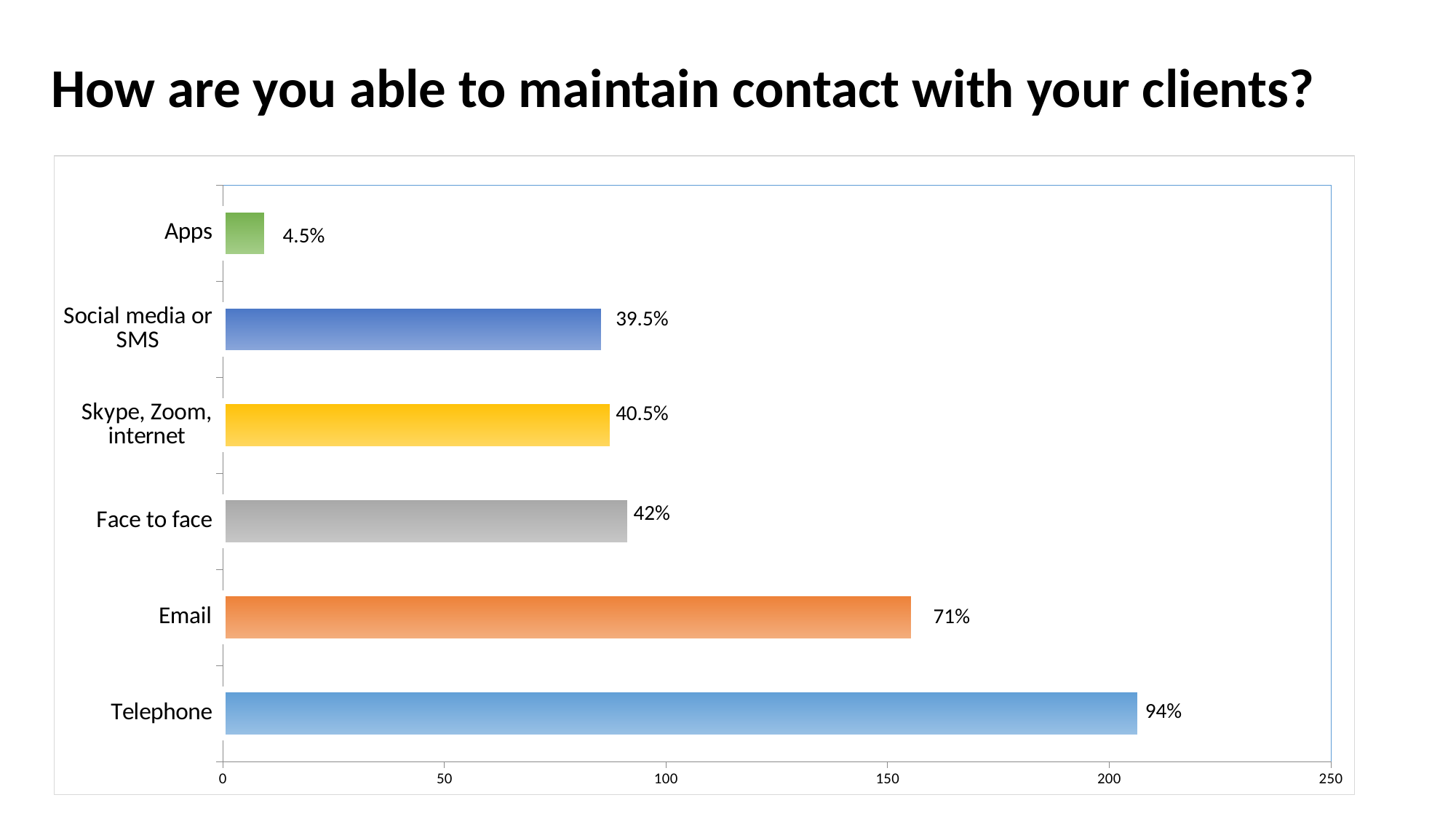
Which category has the highest value? Telephone What is the data label shown for Skype, Zoom, internet? 40.5% Which category has the lowest value? Apps Is the bar for Face to face greater or less than 100 on the horizontal axis? less What is the data label shown for Telephone? 94% What kind of chart is shown on the slide? Bar chart How many categories are shown in the chart? 6 What is the data label shown for Apps? 4.5% What is the data label shown for Email? 71% Which is larger, the value for Email or the value for Face to face? Email Is the bar for Telephone greater or less than 200 on the horizontal axis? greater What is the difference in percentage points between the Telephone and Email labels? 23